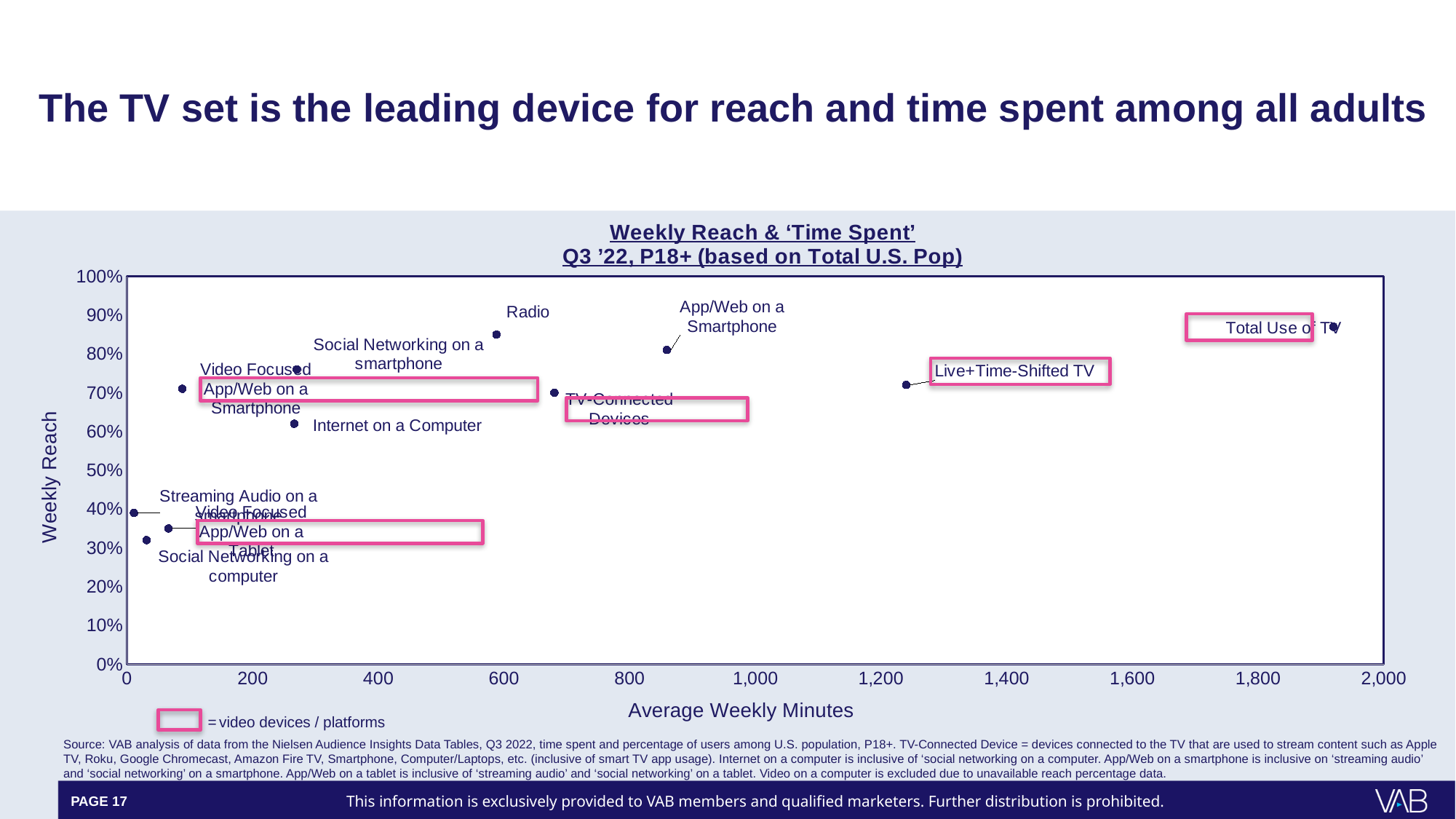
Which has more Average Weekly Minutes, Radio or App/Web on a Smartphone? App/Web on a Smartphone Which platform has the lowest Average Weekly Minutes? Streaming Audio on a smartphone How many platforms are plotted on the chart? 11 What does the x axis of the chart measure? Average Weekly Minutes Is the Weekly Reach for Streaming Audio on a smartphone greater or less than 50%? less Is the Weekly Reach for Internet on a Computer greater or less than 70%? less Is the Average Weekly Minutes value for Live+Time-Shifted TV greater or less than 1,400? less What kind of chart is shown on the slide? Scatter chart Which has more Average Weekly Minutes, Live+Time-Shifted TV or TV-Connected Devices? Live+Time-Shifted TV Which platform has the highest Average Weekly Minutes? Total Use of TV